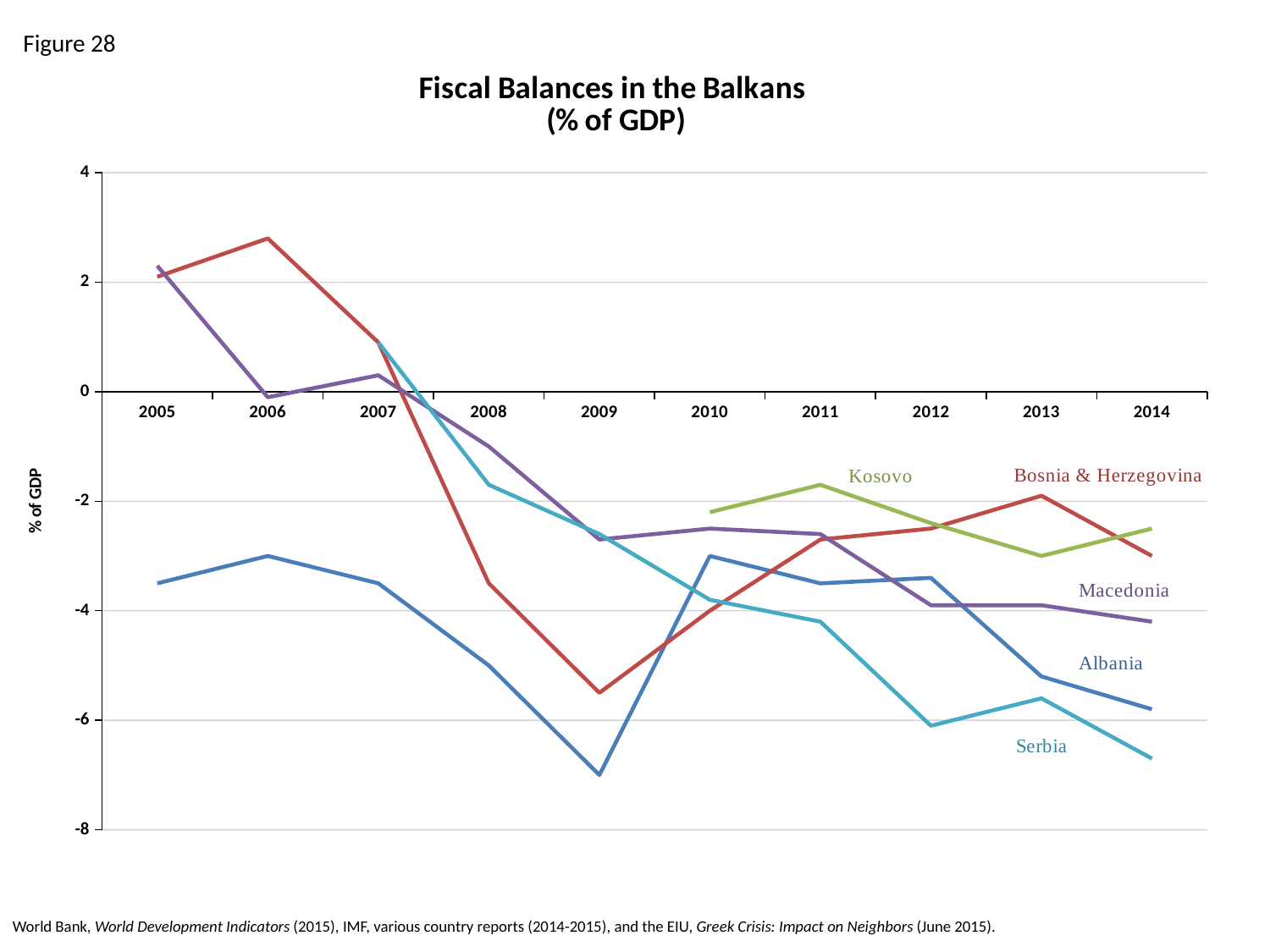
How many countries are plotted in the chart? 5 How many years are shown on the x axis? 10 Which country has the lowest fiscal balance in 2014? Serbia Is the value for Albania in 2009 greater or less than -6? less Does Serbia's fiscal balance rise or fall overall from 2010 to 2014? fall Which country has the lowest fiscal balance in 2009? Albania Is the value for Bosnia & Herzegovina in 2006 greater or less than 2? greater Which country has the highest fiscal balance in 2006? Bosnia & Herzegovina What kind of chart is shown on the slide? line chart Which country's line starts only in 2010? Kosovo Which country has the highest fiscal balance in 2013? Bosnia & Herzegovina In 2014, which has the higher fiscal balance, Albania or Serbia? Albania